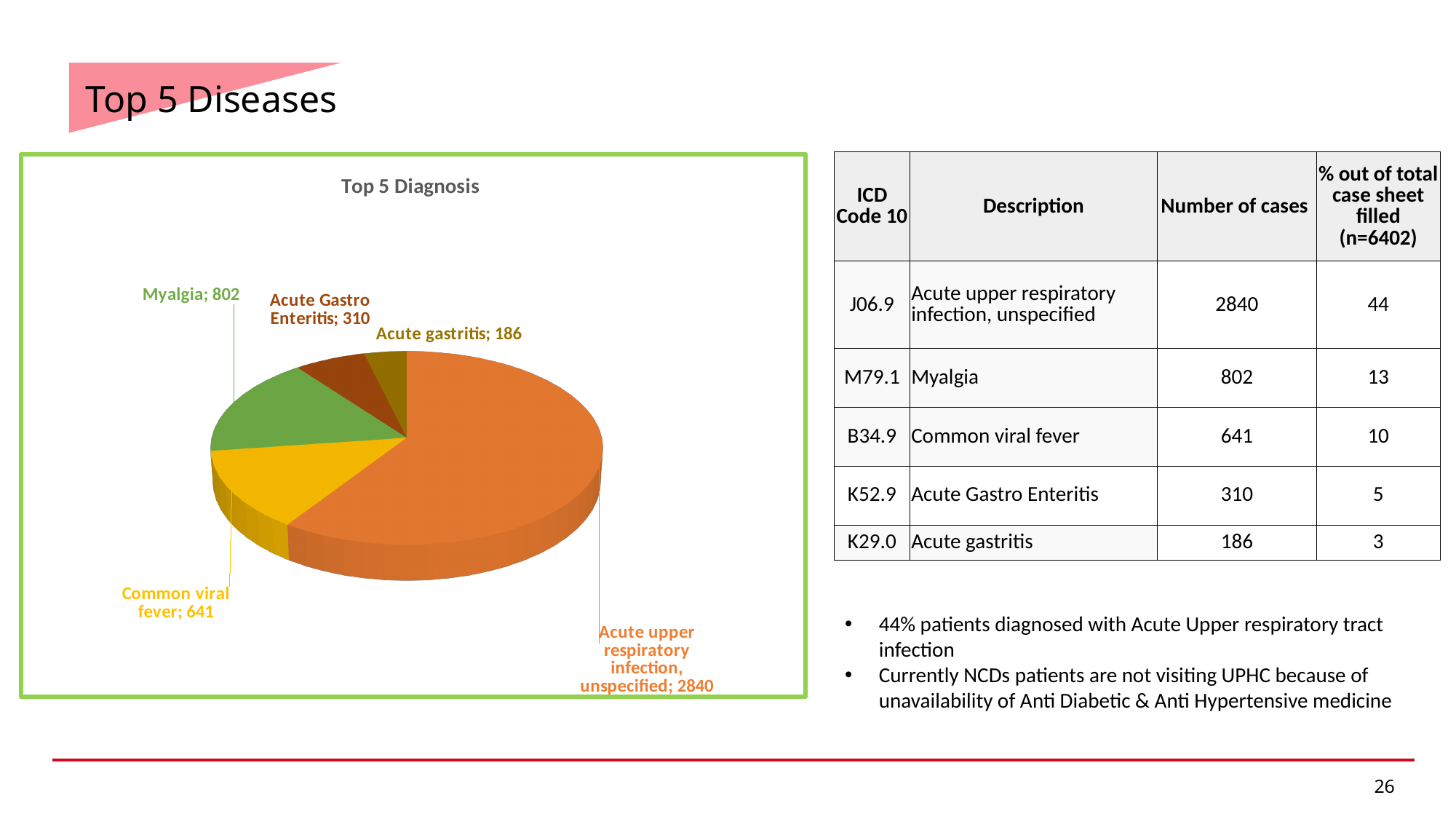
How many slices does the pie chart have? 5 What type of chart is shown on the slide? Pie chart Which diagnosis has the largest slice in the pie chart? Acute upper respiratory infection, unspecified What is the difference between the values for Myalgia and Common viral fever in the pie chart? 161 What is the value shown for Acute Gastro Enteritis in the pie chart? 310 What is the value shown for Acute upper respiratory infection, unspecified in the pie chart? 2840 What is the title of the chart? Top 5 Diagnosis What is the value shown for Common viral fever in the pie chart? 641 Which is larger in the pie chart, Acute Gastro Enteritis or Acute gastritis? Acute Gastro Enteritis Which diagnosis has the smallest slice in the pie chart? Acute gastritis What is the value shown for Myalgia in the pie chart? 802 What is the value shown for Acute gastritis in the pie chart? 186